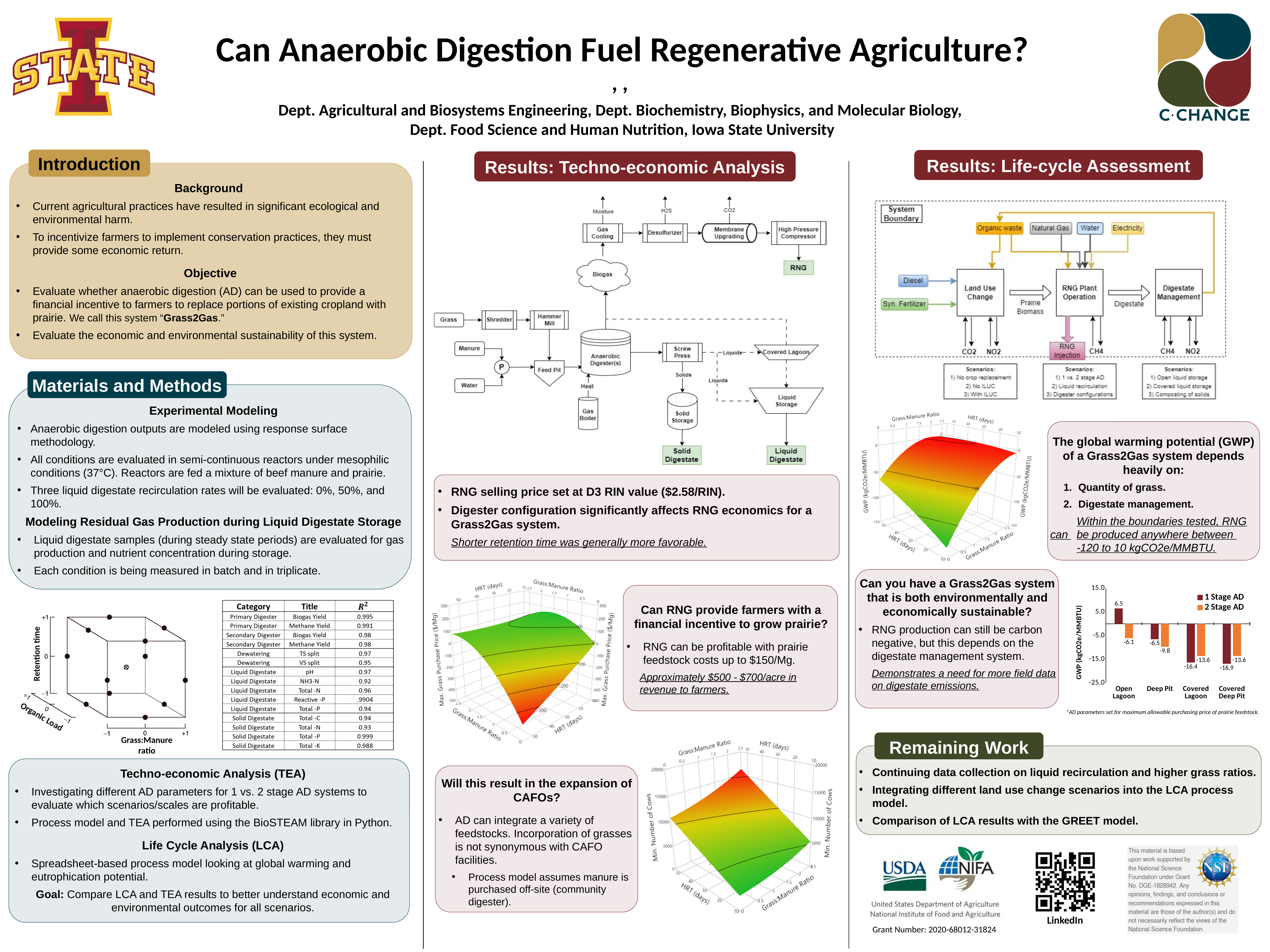
In the GWP bar chart in the Life-cycle Assessment section, is the 1 Stage AD value for Covered Lagoon greater or less than -15.0? less In the GWP bar chart in the Life-cycle Assessment section, which digestate management category has the lowest 1 Stage AD value? Covered Deep Pit In the GWP bar chart in the Life-cycle Assessment section, what is the value for 1 Stage AD at Covered Deep Pit? -16.9 How many series does the legend of the GWP bar chart in the Life-cycle Assessment section list? 2 In the GWP bar chart in the Life-cycle Assessment section, which digestate management category has the highest 1 Stage AD value? Open Lagoon In the GWP bar chart in the Life-cycle Assessment section, what is the value for 1 Stage AD at Open Lagoon? 6.5 In the GWP bar chart in the Life-cycle Assessment section, what is the value for 2 Stage AD at Covered Lagoon? -13.6 In the GWP bar chart in the Life-cycle Assessment section, what is the difference between the 1 Stage AD and 2 Stage AD values at Open Lagoon? 12.6 In the GWP bar chart in the Life-cycle Assessment section, what is the value for 2 Stage AD at Deep Pit? -9.8 What kind of chart is the GWP chart with Open Lagoon, Deep Pit, Covered Lagoon and Covered Deep Pit categories in the Life-cycle Assessment section? Bar chart How many digestate management categories are shown on the x axis of the GWP bar chart in the Life-cycle Assessment section? 4 In the GWP bar chart in the Life-cycle Assessment section, at Deep Pit, which series has the larger value, 1 Stage AD or 2 Stage AD? 1 Stage AD